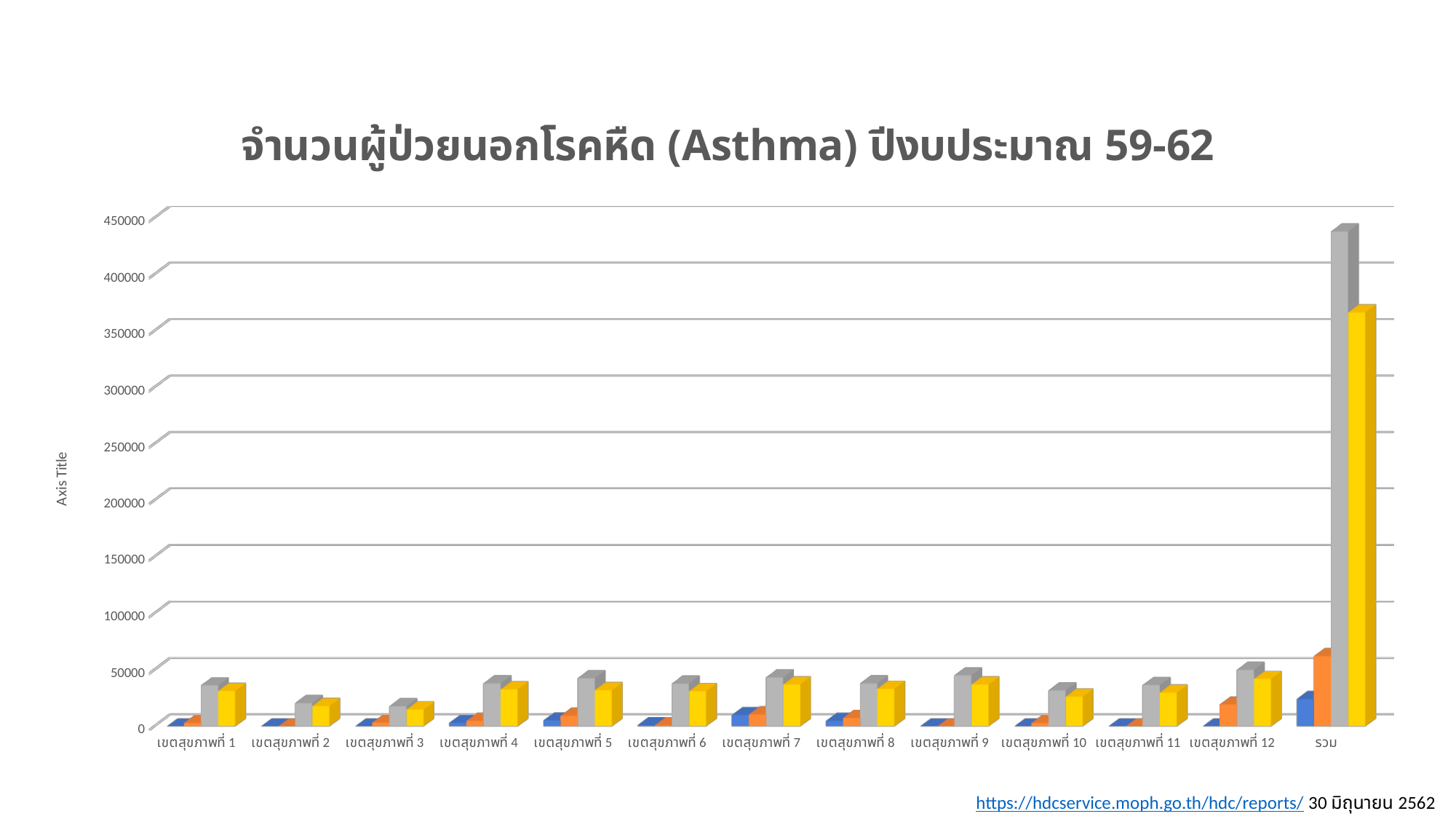
How many bars are plotted for each category? 4 Is the value of the gray bar for รวม greater or less than 400000? greater What kind of chart is shown on the slide? bar chart What is the title of the chart? จำนวนผู้ป่วยนอกโรคหืด (Asthma) ปีงบประมาณ 59-62 How many categories are shown along the x axis? 13 What is the label shown on the vertical axis? Axis Title For รวม, which is larger: the blue bar or the orange bar? the orange bar Is the value of the yellow bar for รวม greater or less than 400000? less Which category has the tallest bars? รวม Is the value of the yellow bar for รวม greater or less than 350000? greater For รวม, which is larger: the gray bar or the yellow bar? the gray bar